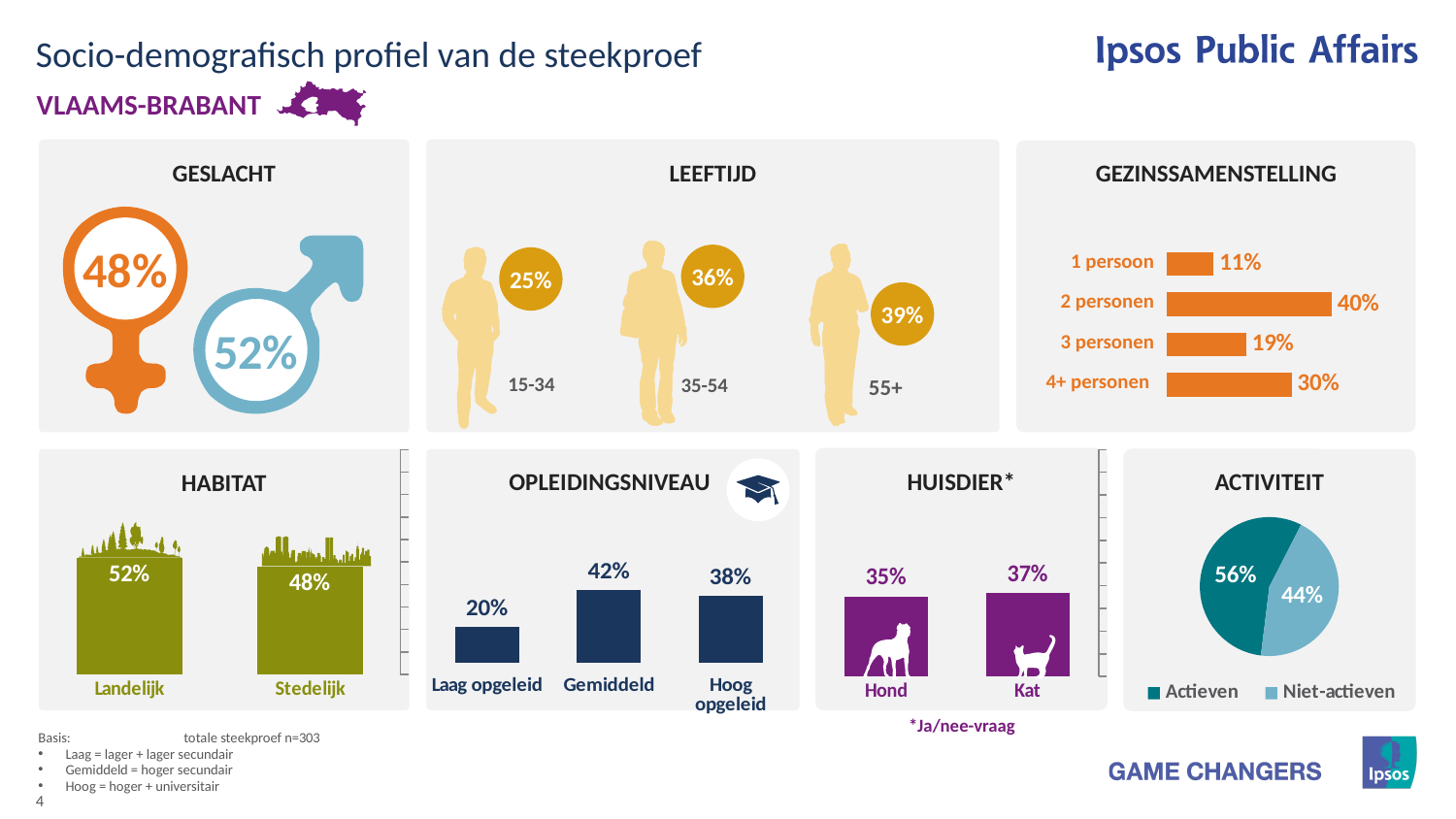
How many categories does the GEZINSSAMENSTELLING chart show? 4 How many series does the legend of the ACTIVITEIT chart list? 2 In the HABITAT chart, which is larger, Landelijk or Stedelijk? Landelijk In the GEZINSSAMENSTELLING chart, which category has the lowest value? 1 persoon In the GEZINSSAMENSTELLING chart, what is the difference between 4+ personen and 3 personen? 11% In the OPLEIDINGSNIVEAU chart, which category has the highest value? Gemiddeld In the ACTIVITEIT pie chart, what share is Actieven? 56% In the HABITAT chart, what is the value for Landelijk? 52% In the OPLEIDINGSNIVEAU chart, what is the value for Laag opgeleid? 20% In the GEZINSSAMENSTELLING chart, what is the value for 2 personen? 40% What kind of chart is the HUISDIER chart? Bar chart In the HUISDIER chart, what is the difference between Kat and Hond? 2%